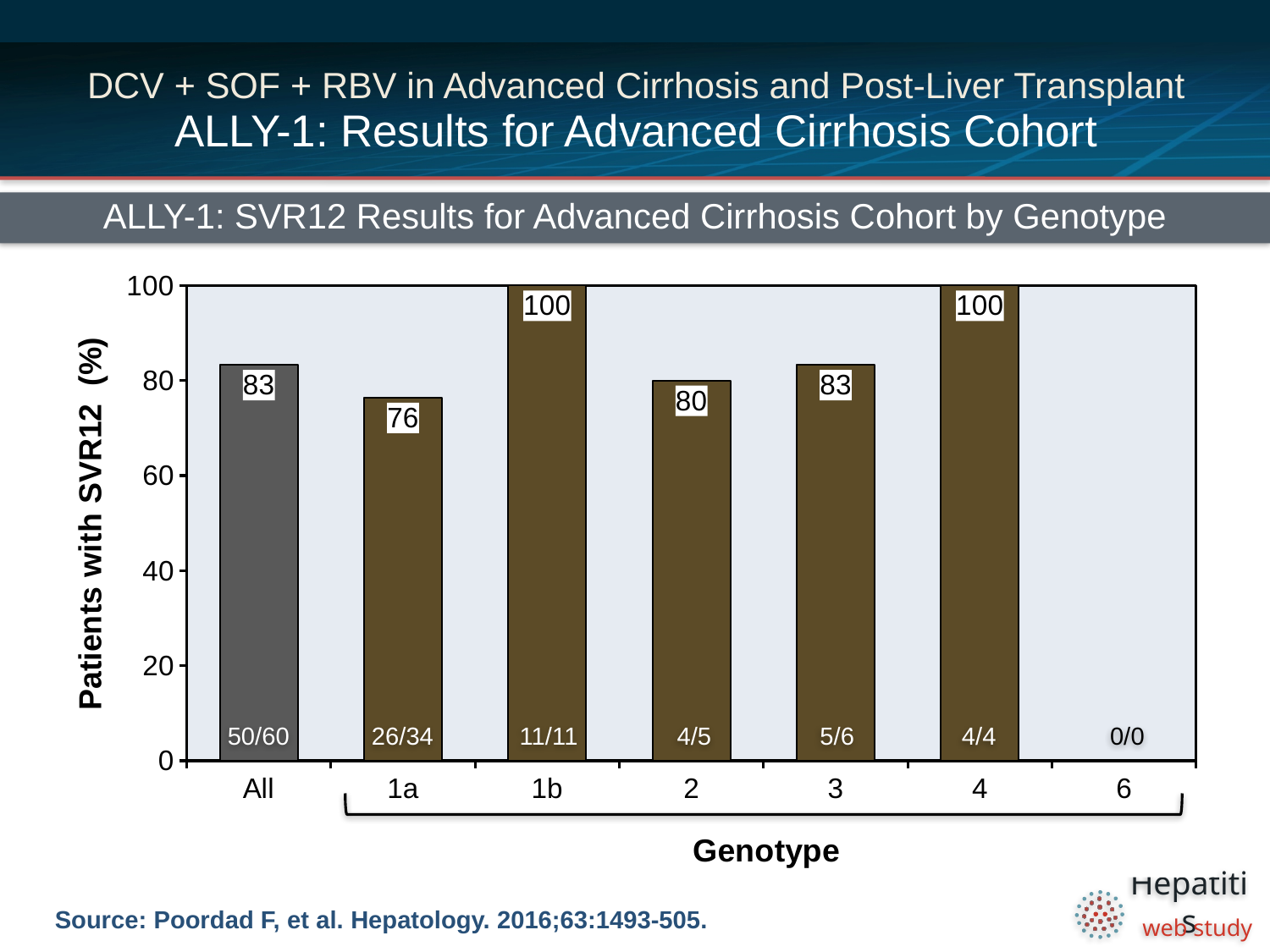
What kind of chart is shown on the slide? bar chart How many categories are labeled on the x axis? 7 What is the difference in SVR12 percentage between genotype 1b and genotype 1a? 24 What fraction of patients is shown for genotype 6? 0/0 What is the SVR12 percentage for genotype 1a? 76 What is the SVR12 percentage for the All group? 83 What is the SVR12 percentage for genotype 2? 80 What is the label of the y axis? Patients with SVR12 (%) Among the genotype bars plotted, which has the lowest SVR12 percentage? 1a Which genotypes have an SVR12 of 100? 1b and 4 What fraction of patients is shown for genotype 3? 5/6 Which has a higher SVR12 percentage, genotype 2 or genotype 3? genotype 3